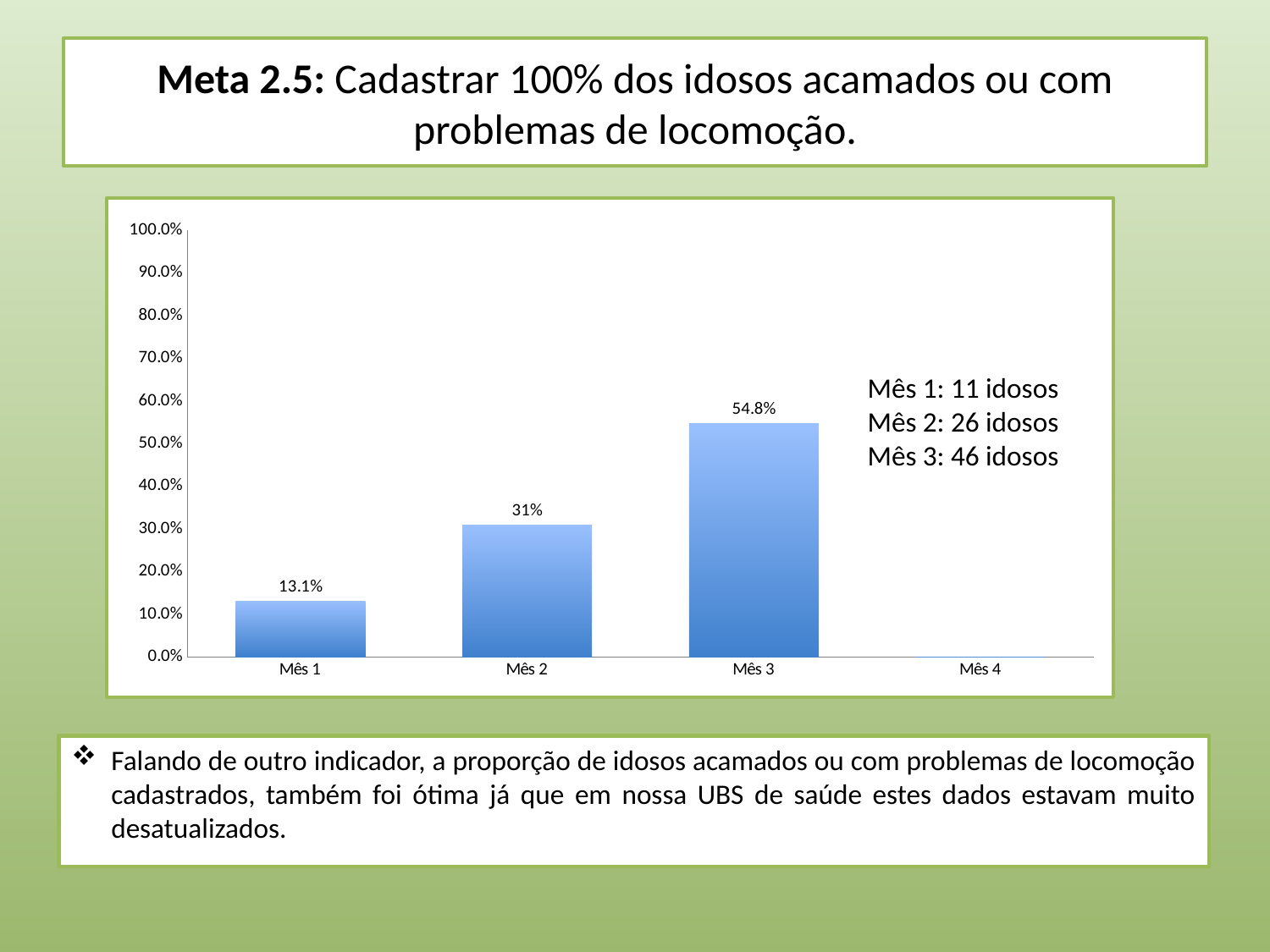
What is the value shown for Mês 1? 13.1% Which month has the highest bar? Mês 3 Do the values rise or fall from Mês 1 to Mês 3? rise What is the difference between the values for Mês 3 and Mês 2? 23.8% What kind of chart is shown on the slide? bar chart Is the value for Mês 1 greater or less than 20%? less Which is larger, the value for Mês 2 or the value for Mês 1? Mês 2 What is the value shown for Mês 2? 31% How many categories are shown on the x axis? 4 Is the value for Mês 3 greater or less than 50%? greater What is the difference between the values for Mês 2 and Mês 1? 17.9% What is the value shown for Mês 3? 54.8%